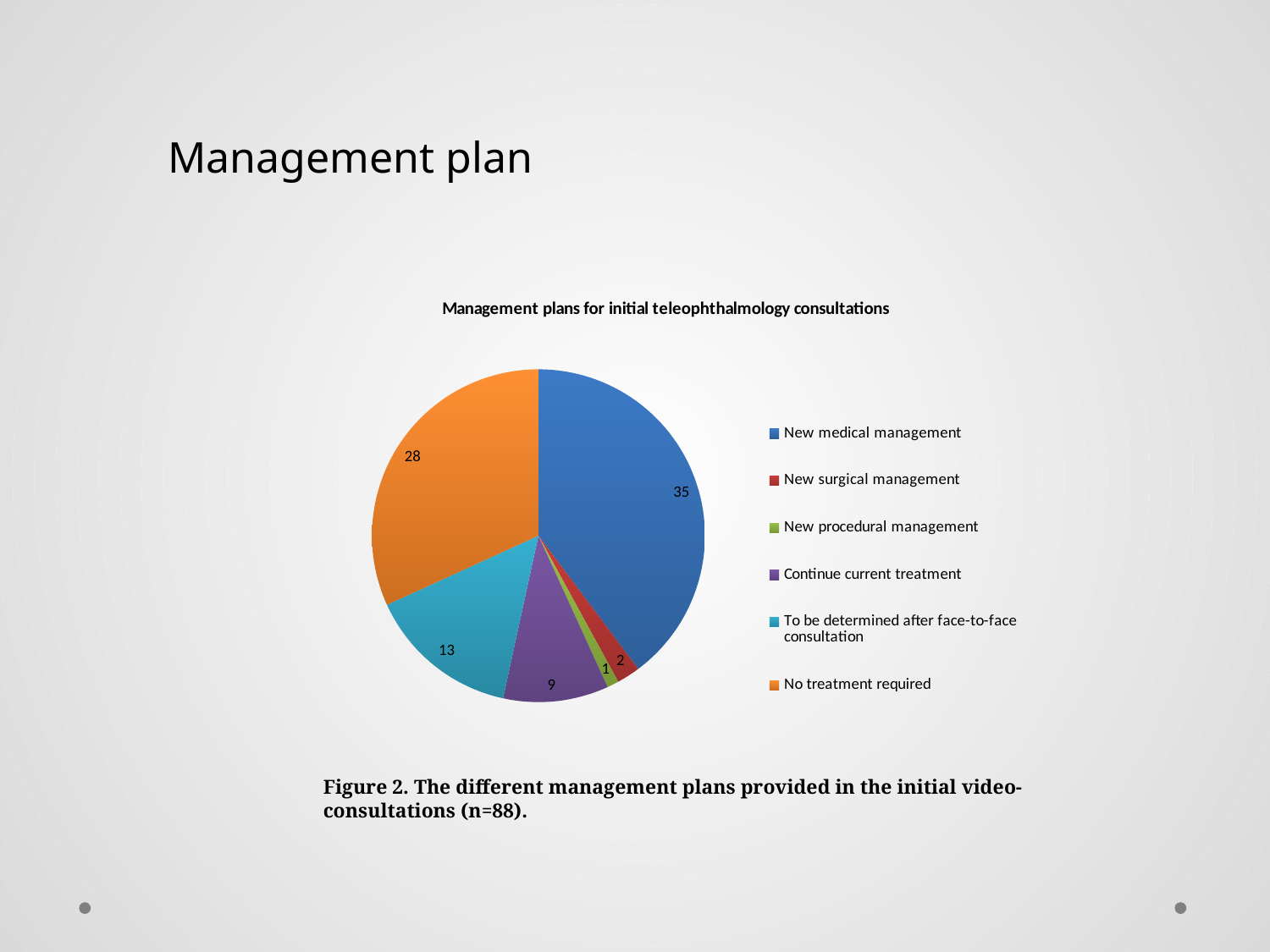
What type of chart is shown on the slide? pie chart What is the value for New medical management? 35 How many categories does the pie chart show? 6 What is the difference between the values for New medical management and No treatment required? 7 What is the value for Continue current treatment? 9 What is the value for New surgical management? 2 Which category has the smallest slice of the pie? New procedural management What is the title of the chart? Management plans for initial teleophthalmology consultations Which category has the largest slice of the pie? New medical management What is the value for To be determined after face-to-face consultation? 13 What is the value for No treatment required? 28 Which is larger, the value for To be determined after face-to-face consultation or the value for Continue current treatment? To be determined after face-to-face consultation